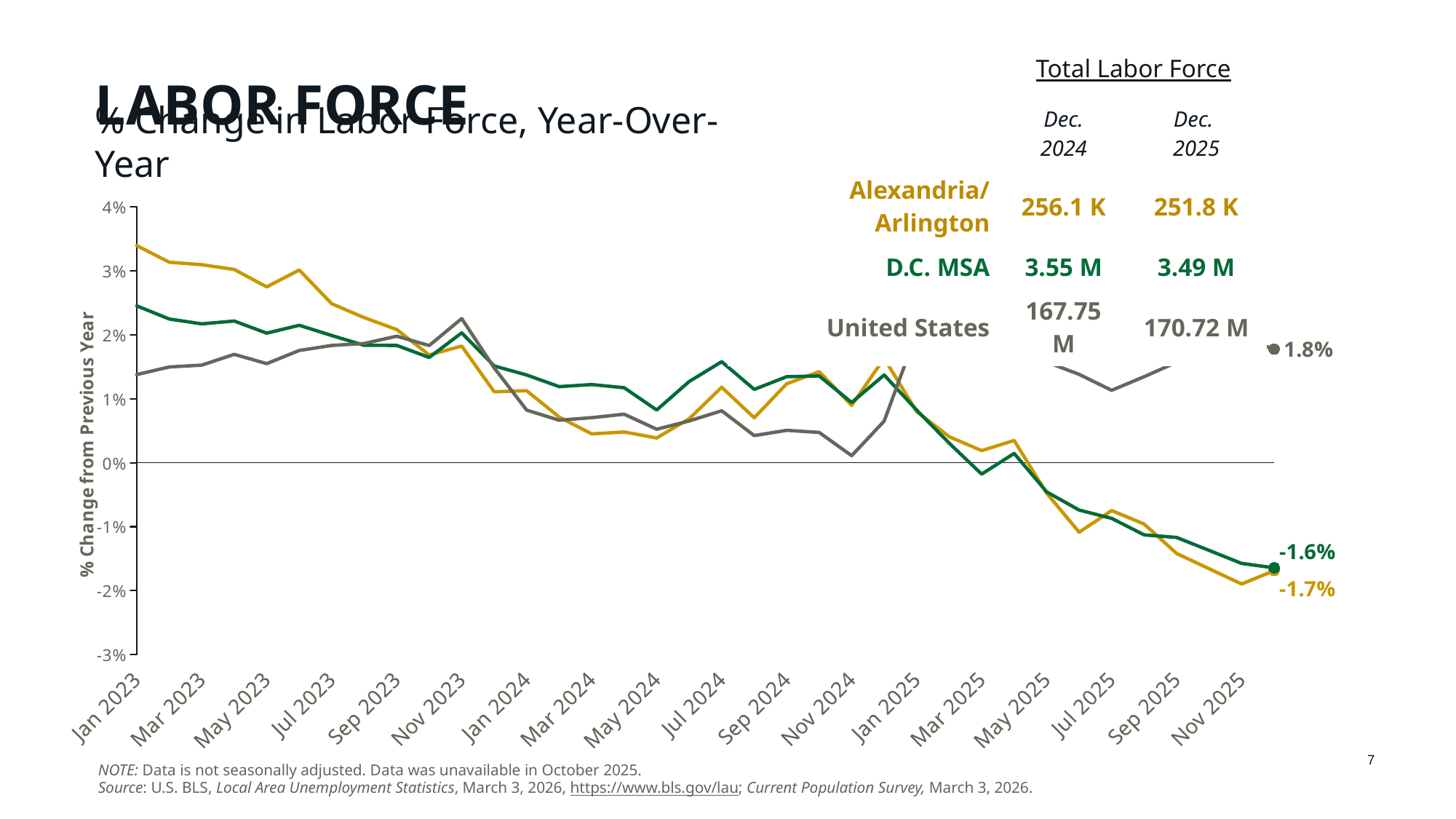
Is the United States value in Jan 2023 greater or less than 2%? less What is the year-over-year % change in labor force for the United States at the last labelled point? 1.8% What is the year-over-year % change in labor force for D.C. MSA at the last point (Nov 2025)? -1.6% Does the Alexandria/Arlington line generally rise or fall from Jan 2023 to Nov 2025? fall What kind of chart is shown on the slide? line chart Is the Alexandria/Arlington value in Jan 2023 greater or less than 3%? greater At the end of the chart, which is higher: the United States value or the D.C. MSA value? United States What is the year-over-year % change in labor force for Alexandria/Arlington at the last point (Nov 2025)? -1.7% What is the difference between the final D.C. MSA value (-1.6%) and the final Alexandria/Arlington value (-1.7%)? 0.1 percentage points Which series has the highest value in Jan 2023? Alexandria/Arlington How many lines (series) are plotted on the chart? 3 What is the difference between the final labelled United States value (1.8%) and the final D.C. MSA value (-1.6%)? 3.4 percentage points